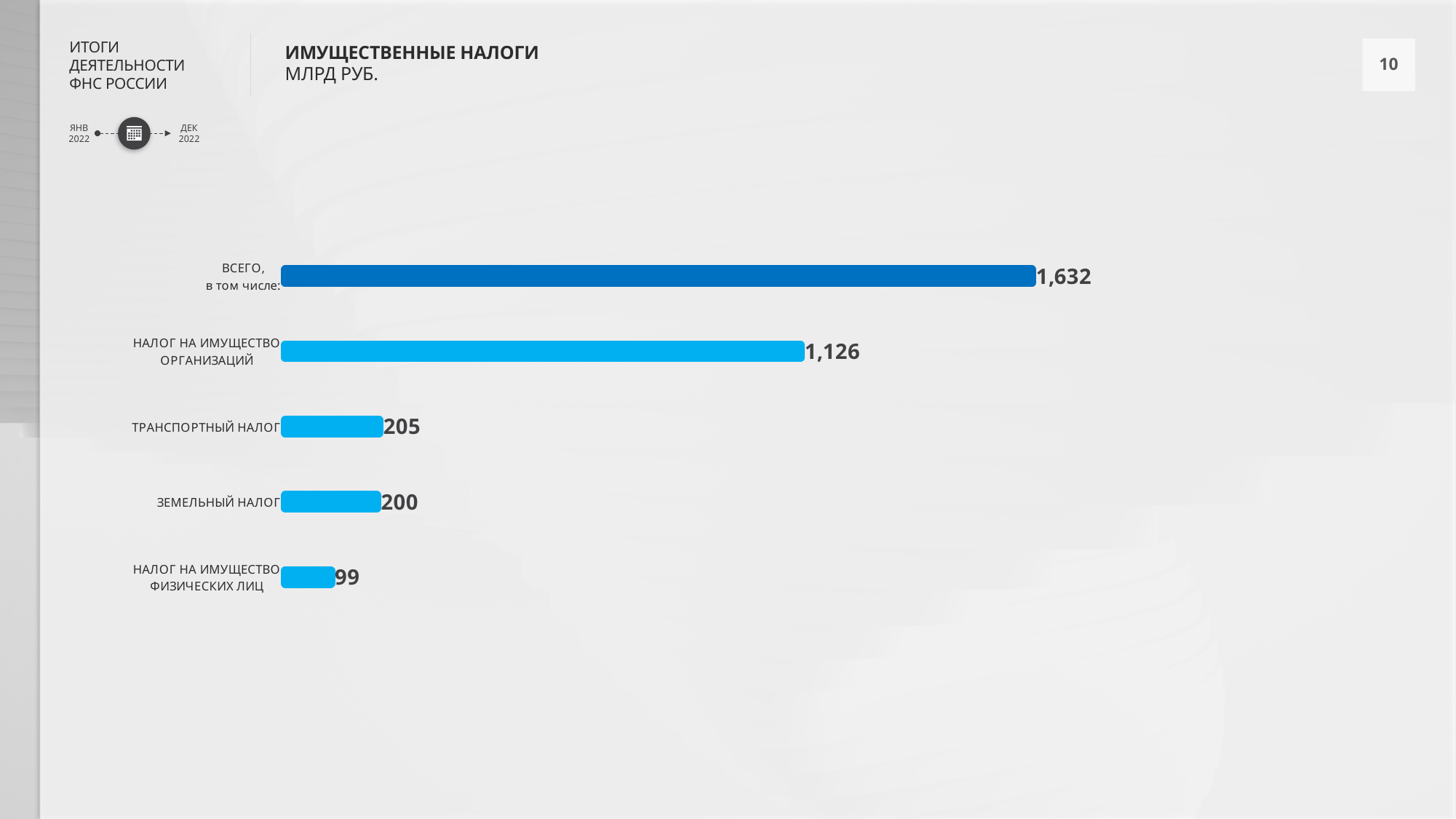
What is the value for ВСЕГО, в том числе? 1,632 Which category has the lowest value? НАЛОГ НА ИМУЩЕСТВО ФИЗИЧЕСКИХ ЛИЦ Which is larger, ЗЕМЕЛЬНЫЙ НАЛОГ or НАЛОГ НА ИМУЩЕСТВО ФИЗИЧЕСКИХ ЛИЦ? ЗЕМЕЛЬНЫЙ НАЛОГ What is the difference between ВСЕГО and НАЛОГ НА ИМУЩЕСТВО ОРГАНИЗАЦИЙ? 506 What is the value for ЗЕМЕЛЬНЫЙ НАЛОГ? 200 Excluding the total bar, which category has the highest value? НАЛОГ НА ИМУЩЕСТВО ОРГАНИЗАЦИЙ What is the value for НАЛОГ НА ИМУЩЕСТВО ОРГАНИЗАЦИЙ? 1,126 What is the value for НАЛОГ НА ИМУЩЕСТВО ФИЗИЧЕСКИХ ЛИЦ? 99 What is the value for ТРАНСПОРТНЫЙ НАЛОГ? 205 What is the difference between ТРАНСПОРТНЫЙ НАЛОГ and ЗЕМЕЛЬНЫЙ НАЛОГ? 5 What kind of chart is shown on the slide? Bar chart How many bars are shown in the chart? 5